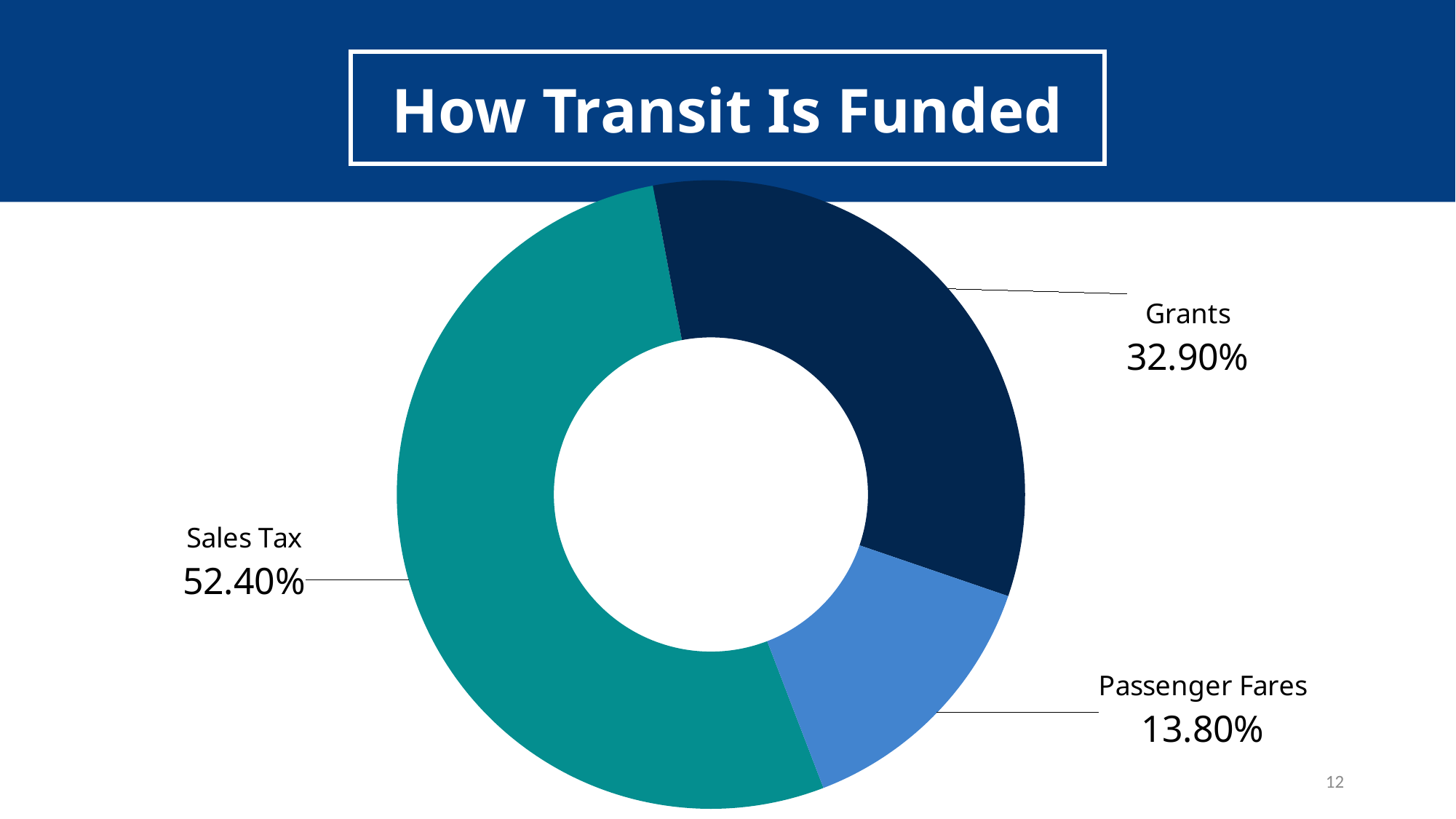
What share of transit funding comes from Passenger Fares? 13.80% What is the title of the slide containing the chart? How Transit Is Funded What share of transit funding comes from Grants? 32.90% What share of transit funding comes from Sales Tax? 52.40% What kind of chart is shown on the slide? Doughnut (pie) chart Which funding source has the largest share? Sales Tax Which is larger, the share for Grants or the share for Passenger Fares? Grants How many funding sources are shown in the chart? 3 What is the difference in percentage points between the Grants share and the Passenger Fares share? 19.10% Which funding source has the smallest share? Passenger Fares What is the difference in percentage points between the Sales Tax share and the Grants share? 19.50% What colour is the Sales Tax slice? Teal